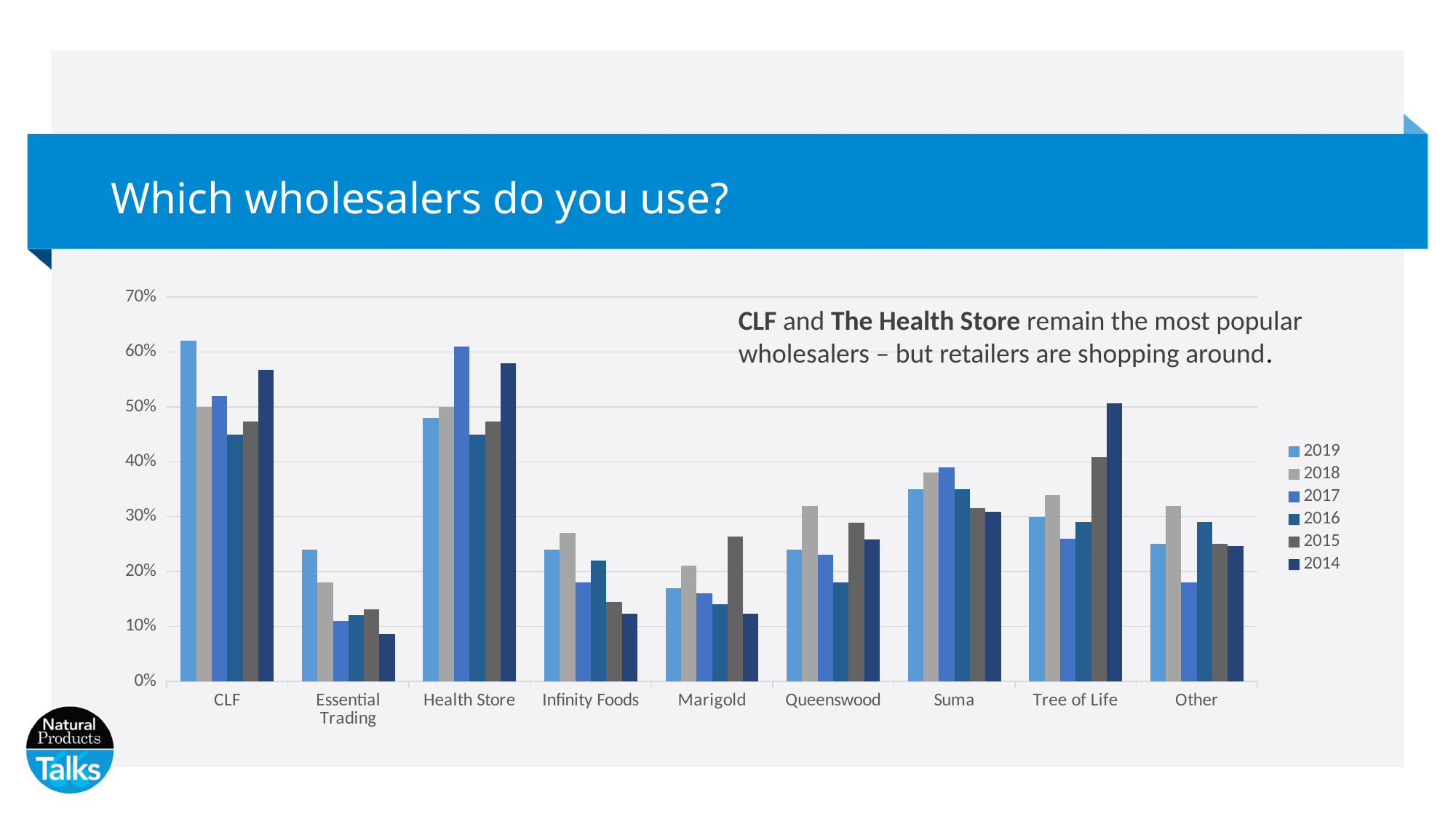
What kind of chart is shown on the slide? bar chart Is the value for CLF in 2019 greater or less than 60%? greater What is the title of the slide containing the chart? Which wholesalers do you use? How many series does the legend list? 6 Is the value for Marigold in 2015 greater or less than 20%? greater Which year has the highest value for Essential Trading? 2019 Which is larger in 2019: the value for CLF or the value for Essential Trading? CLF Is the value for Queenswood in 2016 greater or less than 20%? less Which year has the highest value for Tree of Life? 2014 How many wholesaler categories are shown on the x axis? 9